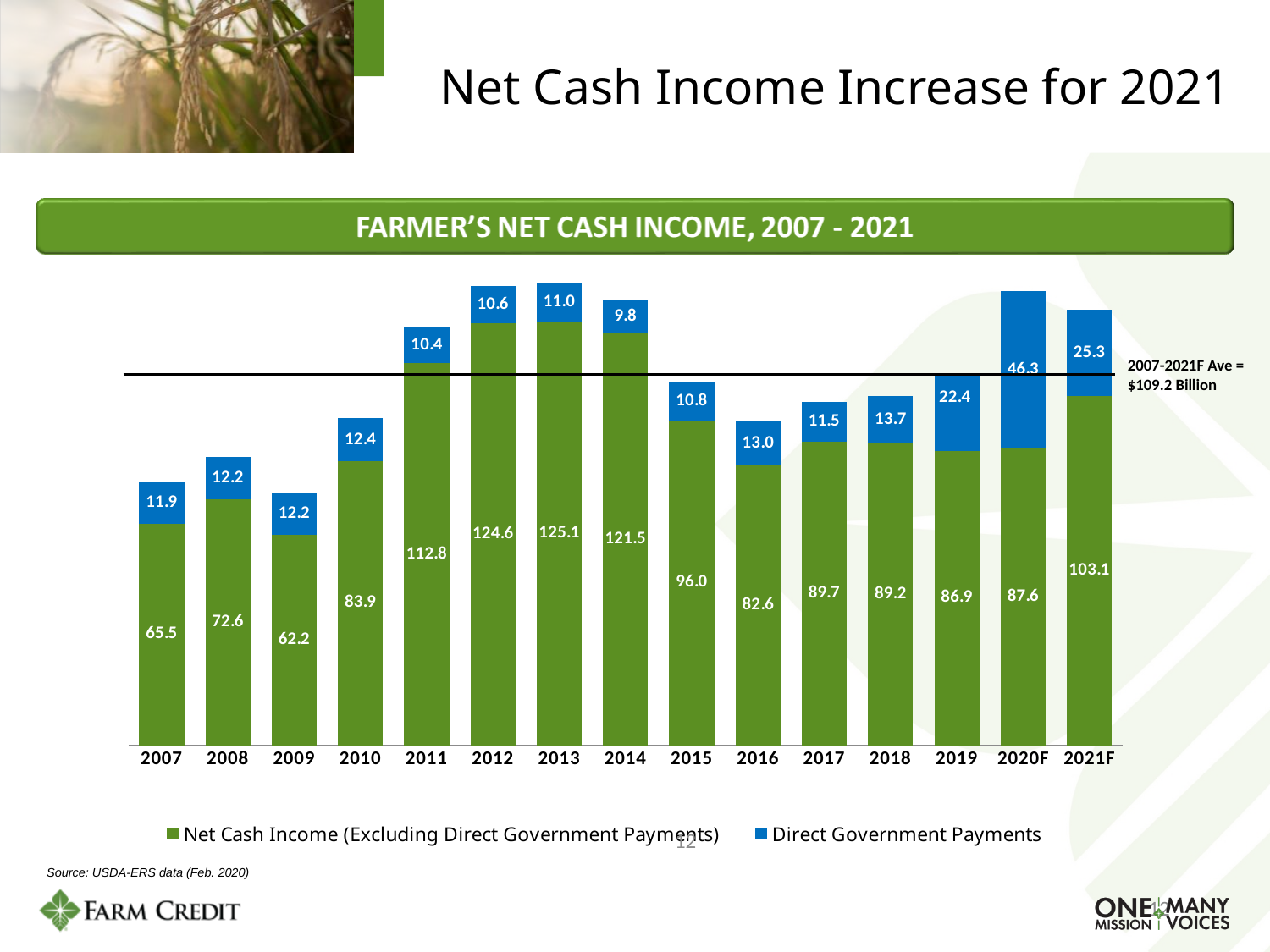
What is the Direct Government Payments value for 2020F? 46.3 How many series does the legend list? 2 What is the Net Cash Income (Excluding Direct Government Payments) value for 2021F? 103.1 How many years are shown on the x axis? 15 What is the 2007-2021F average value noted on the chart? $109.2 Billion What kind of chart is shown? Stacked bar chart What is the total height of the stacked bar for 2020F? 133.9 Which is larger, the Direct Government Payments for 2019 or for 2021F? 2021F Which year has the highest Direct Government Payments? 2020F Which year has the highest Net Cash Income (Excluding Direct Government Payments)? 2013 Which year has the lowest Net Cash Income (Excluding Direct Government Payments)? 2009 What is the difference in Net Cash Income (Excluding Direct Government Payments) between 2021F and 2020F? 15.5